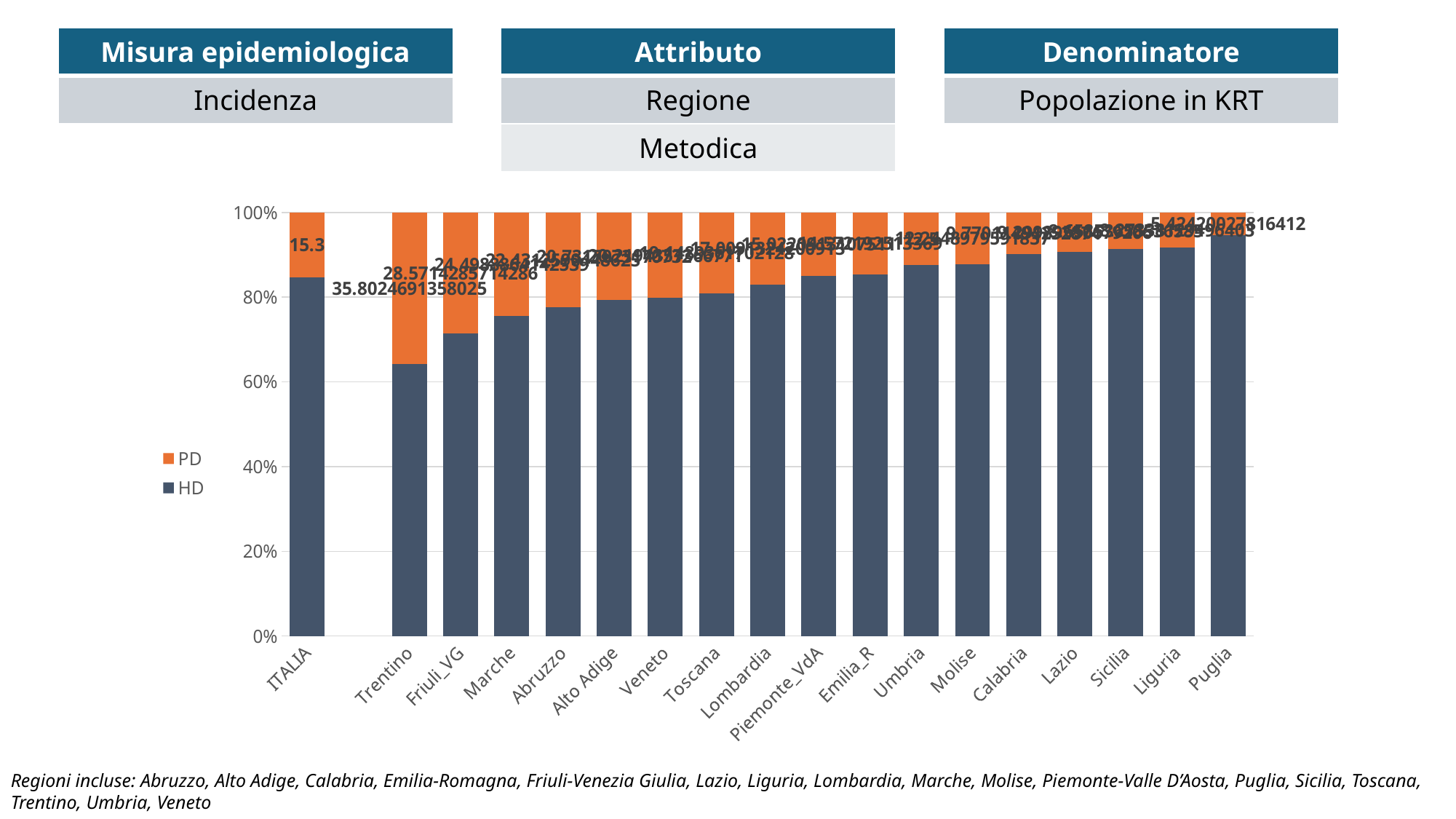
What are the two series named in the legend? PD and HD How many series does the legend list? 2 Which has the larger HD share, Trentino or Puglia? Puglia Which region has the largest PD share? Trentino Is the HD share for ITALIA greater or less than 80%? greater Which region has the smallest PD share? Puglia Excluding ITALIA, do the HD shares rise or fall from left to right along the x axis? rise Which region has the smallest HD share? Trentino What kind of chart is shown on the slide? Stacked bar chart Is the HD share for Trentino greater or less than 80%? less What is the PD data label shown for ITALIA? 15.3 How many categories are shown along the x axis? 18